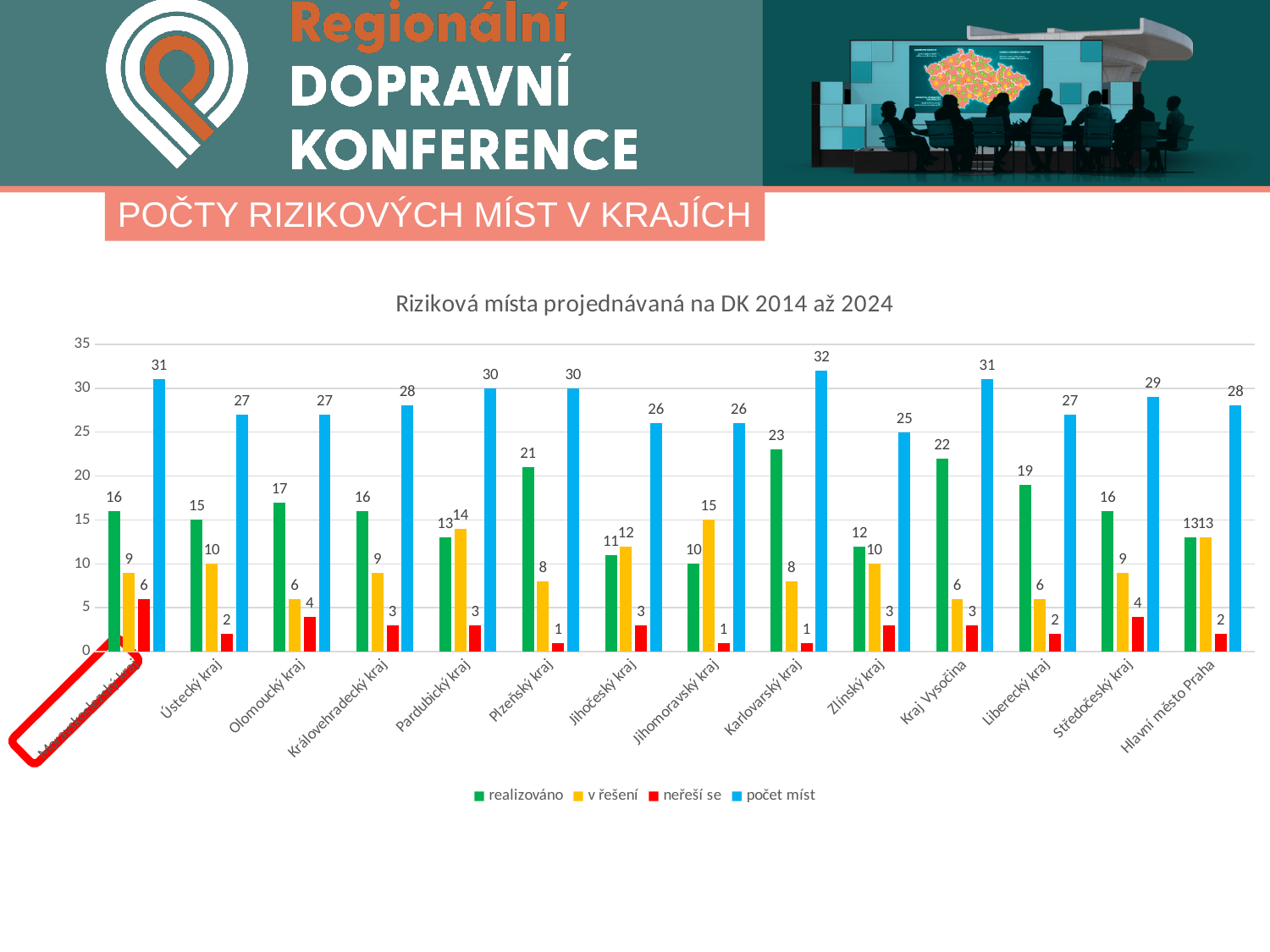
What is the title of the chart? Riziková místa projednávaná na DK 2014 až 2024 Which region has the lowest value of 'počet míst'? Zlínský kraj What is the value of 'neřeší se' for Olomoucký kraj? 4 What is the value of 'realizováno' for Plzeňský kraj? 21 What is the value of 'počet míst' for Karlovarský kraj? 32 What is the difference between 'počet míst' and 'realizováno' for Kraj Vysočina? 9 Which is larger for Liberecký kraj: 'realizováno' or 'v řešení'? realizováno How many series does the legend list? 4 Which region has the highest value of 'počet míst'? Karlovarský kraj Is the value of 'počet míst' for Středočeský kraj greater or less than 25? greater What type of chart is shown on the slide? bar chart What is the value of 'v řešení' for Jihomoravský kraj? 15